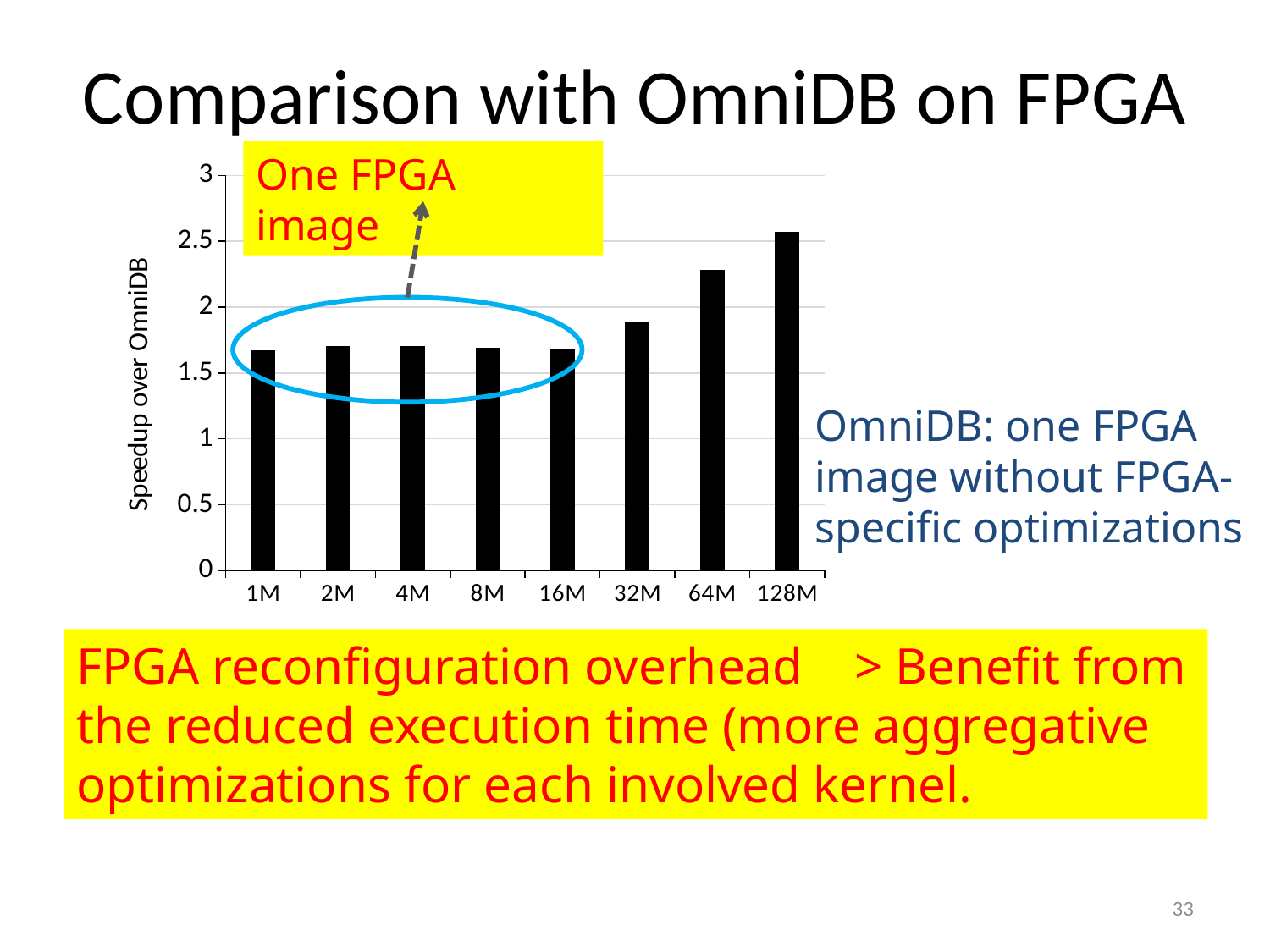
Do the speedup values generally rise or fall as the data size increases from 1M to 128M? rise How many data sizes (categories) are plotted on the x axis? 8 Is the speedup for 16M greater or less than 2? less Is the speedup for 1M greater or less than 1.5? greater Which data size has the highest speedup over OmniDB? 128M What kind of chart is shown on the slide? bar chart Which has a larger speedup, 64M or 128M? 128M Is the speedup for 32M greater or less than 2? less Which has a larger speedup, 16M or 32M? 32M What is the label on the y axis of the chart? Speedup over OmniDB